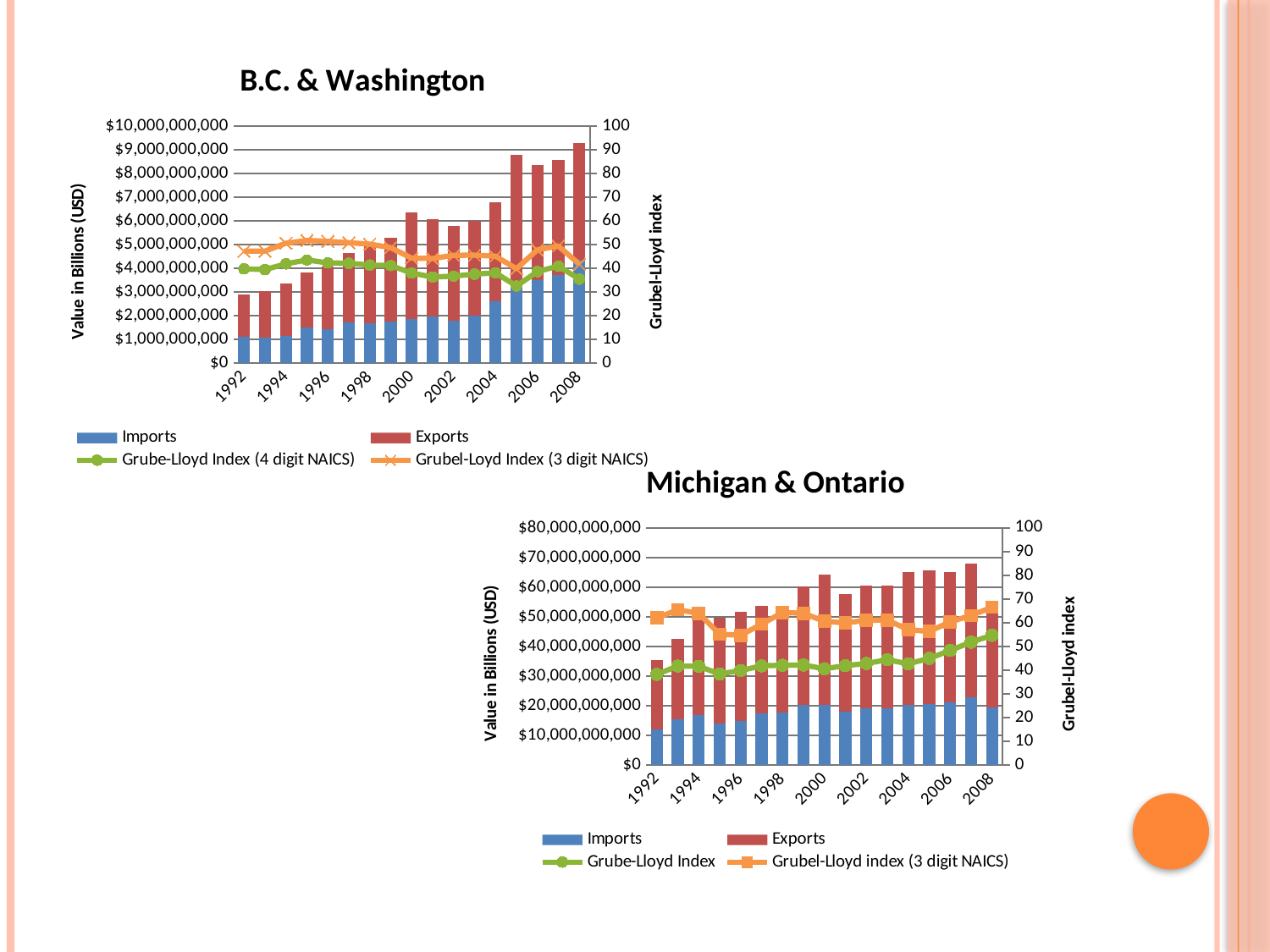
On the Michigan & Ontario chart, does the Grube-Lloyd Index line generally rise or fall from 1992 to 2008? rise On the Michigan & Ontario chart, is the total stacked bar for 2008 greater or less than $60,000,000,000? less On the Michigan & Ontario chart, in 2000, which is larger: Imports or Exports? Exports On the Michigan & Ontario chart, is the total stacked bar for 1992 greater or less than $40,000,000,000? less On the B.C. & Washington chart, is the Grube-Lloyd Index (4 digit NAICS) value for 2005 greater or less than 40? less On the B.C. & Washington chart, what type of chart is used to show Imports and Exports? bar chart On the B.C. & Washington chart, how many series does the legend list? 4 On the Michigan & Ontario chart, which year has the tallest total stacked bar? 2007 On the B.C. & Washington chart, which year has the shortest total stacked bar? 1992 On the B.C. & Washington chart, what is the title of the right-hand vertical axis? Grubel-Lloyd index